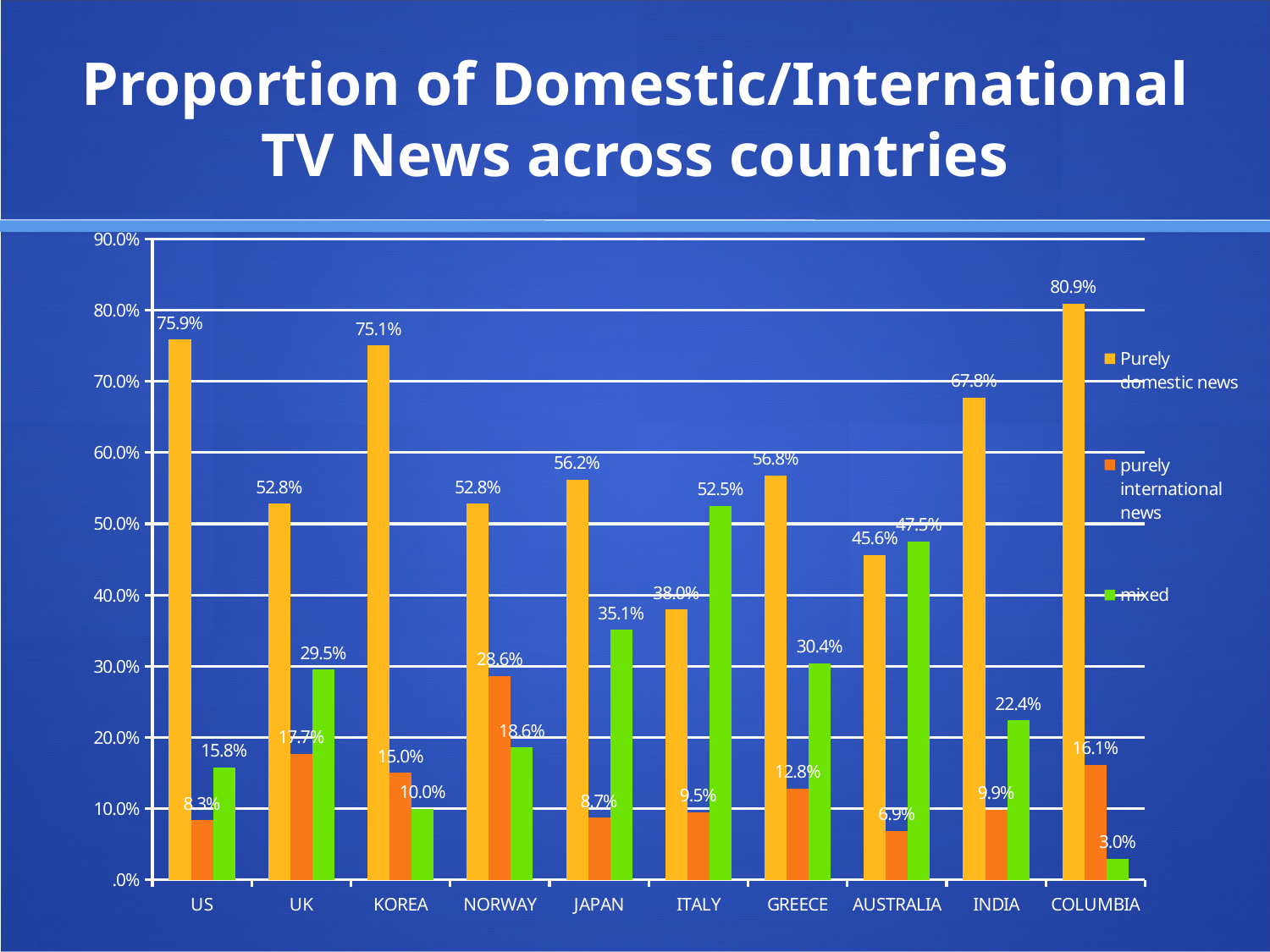
What is the value for purely international news in Norway? 28.6% Which country has the lowest value for purely domestic news? ITALY What is the value for purely domestic news in Columbia? 80.9% How many countries are shown on the x axis? 10 What kind of chart is shown on the slide? Bar chart What is the title of the chart on the slide? Proportion of Domestic/International TV News across countries Which is larger, the mixed news value for Japan or for Greece? Japan What is the value for mixed news in Italy? 52.5% Which country has the highest value for purely domestic news? COLUMBIA Which country has the lowest value for mixed news? COLUMBIA What is the difference between the purely domestic news values for the US and the UK? 23.1% How many series does the legend list? 3